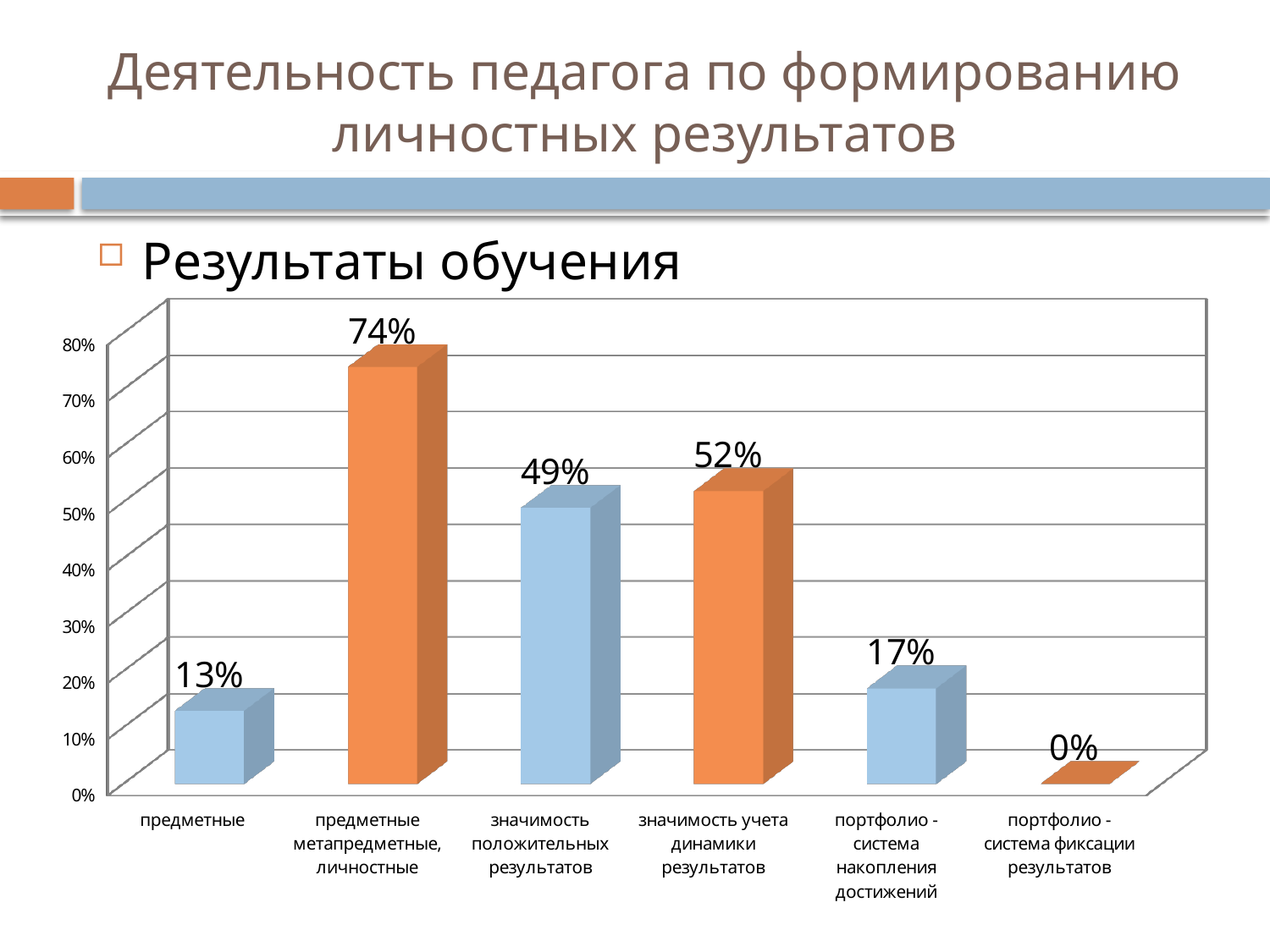
How many categories are shown on the chart? 6 Which category has the lowest value? портфолио - система фиксации результатов What is the value for «значимость положительных результатов»? 49% What is the value for «предметные метапредметные, личностные»? 74% What is the value for «предметные»? 13% Which is larger: «портфолио - система накопления достижений» or «предметные»? портфолио - система накопления достижений What is the value for «портфолио - система фиксации результатов»? 0% What is the difference between «значимость учета динамики результатов» and «значимость положительных результатов»? 3% What is the difference between the highest and lowest values on the chart? 74% Which category has the highest value? предметные метапредметные, личностные Is the value for «значимость учета динамики результатов» greater or less than 40%? greater What kind of chart is shown on the slide? bar chart